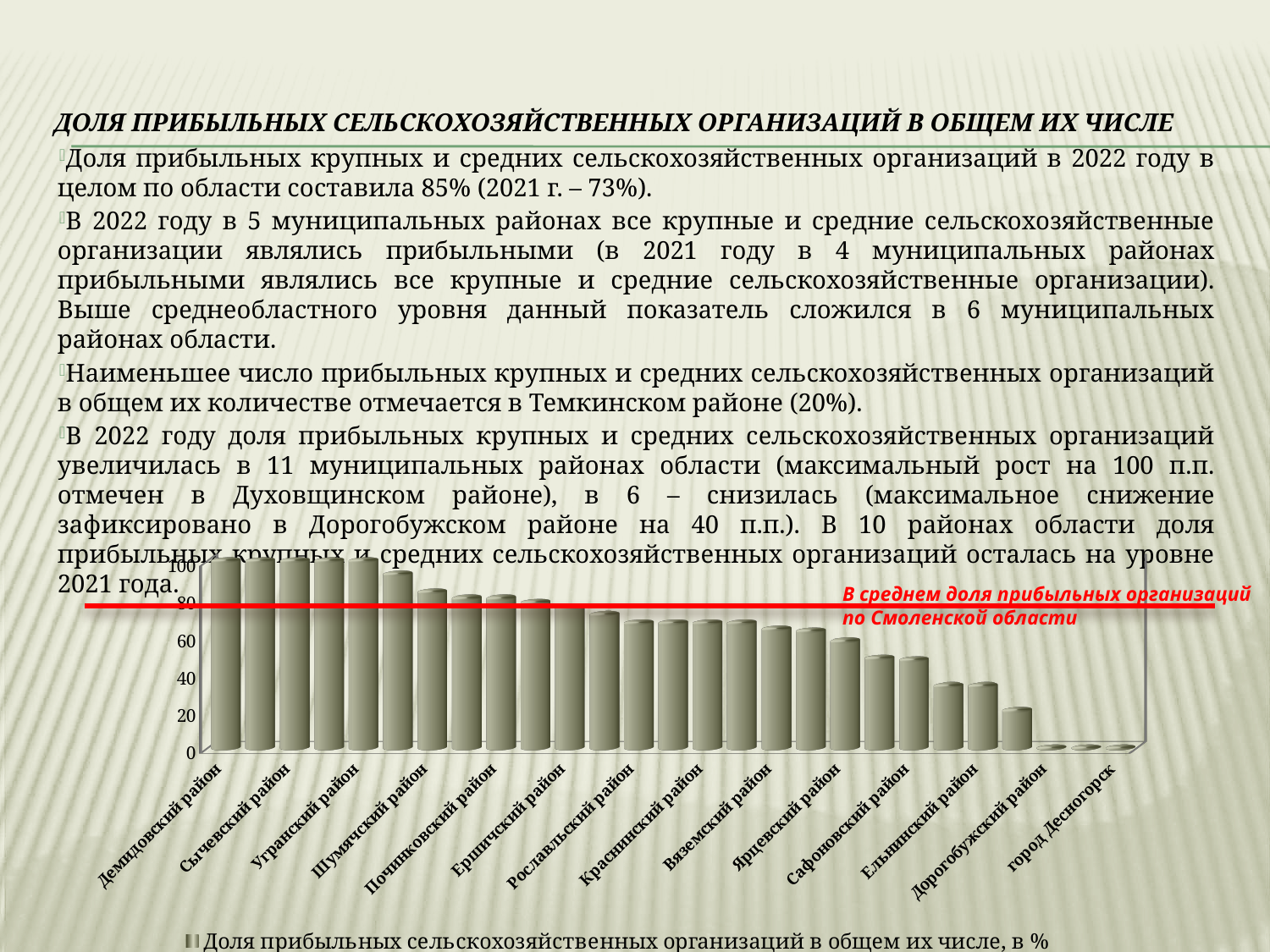
Is the value for Ельнинский район greater or less than 60? less What kind of chart is shown on the slide? bar chart How many series does the chart legend list? 1 Which has the larger value, Демидовский район or Ельнинский район? Демидовский район Is the value for Краснинский район greater or less than 80? less What is the legend entry of the chart? Доля прибыльных сельскохозяйственных организаций в общем их числе, в % Is the value for город Десногорск greater or less than 20? less What does the red horizontal line on the chart represent? В среднем доля прибыльных организаций по Смоленской области